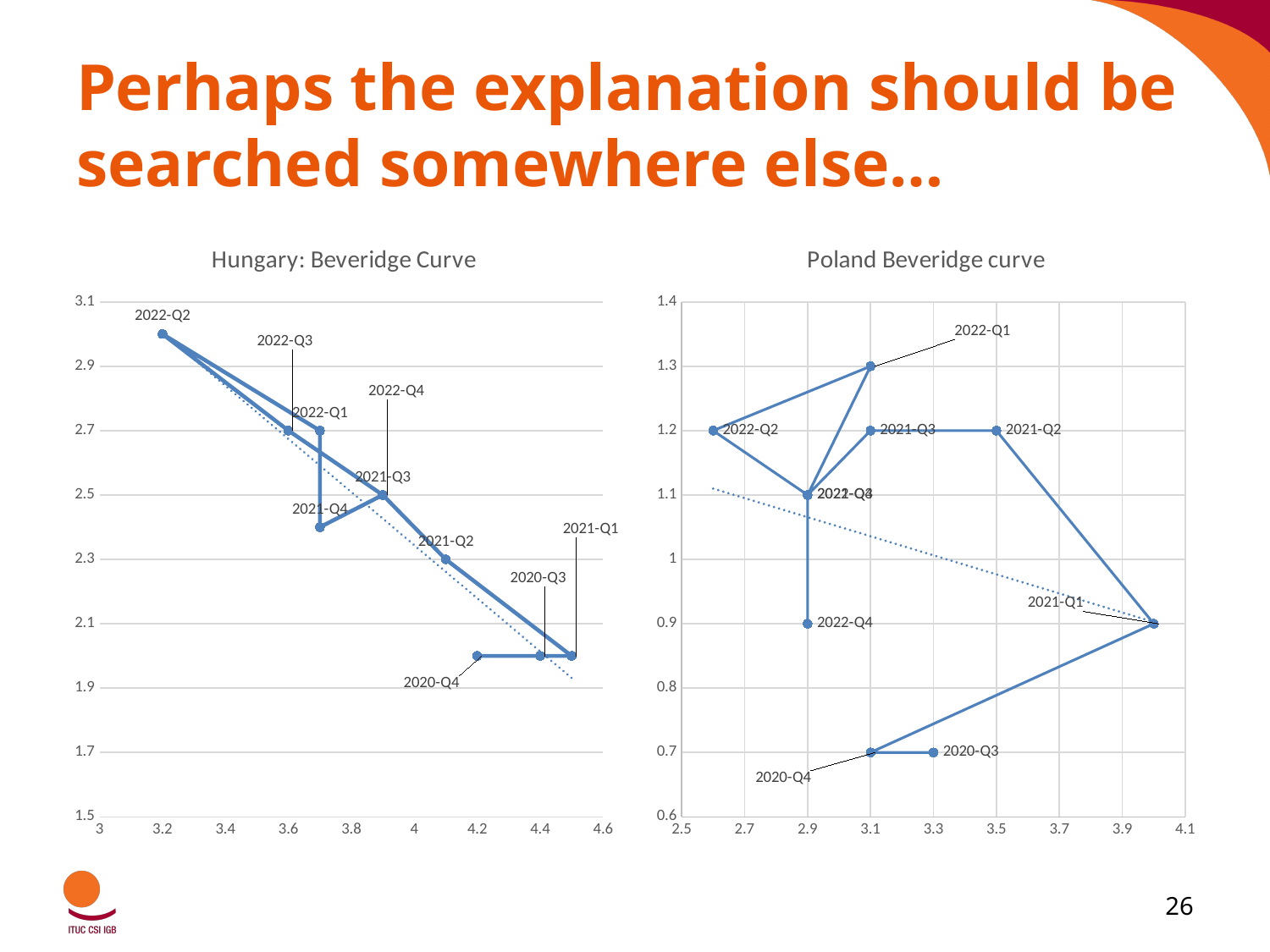
In the Poland Beveridge curve chart, which point lies furthest to the left on the horizontal axis? 2022-Q2 In the Poland Beveridge curve chart, what is the vertical-axis value of the 2022-Q4 point? 0.9 In the Hungary: Beveridge Curve chart, is the vertical-axis value of the 2022-Q2 point greater or less than 2.9? greater In the Poland Beveridge curve chart, which quarter has the highest vertical-axis value? 2022-Q1 In the Poland Beveridge curve chart, what is the horizontal-axis value of the 2021-Q2 point? 3.5 What is the title of the chart on the left? Hungary: Beveridge Curve What is the title of the chart on the right? Poland Beveridge curve In the Poland Beveridge curve chart, what is the difference between the vertical-axis values of the 2022-Q1 and 2022-Q4 points? 0.4 In the Hungary: Beveridge Curve chart, what is the vertical-axis value of the 2021-Q2 point? 2.3 In the Poland Beveridge curve chart, what is the vertical-axis value of the 2022-Q1 point? 1.3 In the Hungary: Beveridge Curve chart, what is the vertical-axis value of the 2022-Q3 point? 2.7 In the Hungary: Beveridge Curve chart, which quarter has the highest vertical-axis value? 2022-Q2